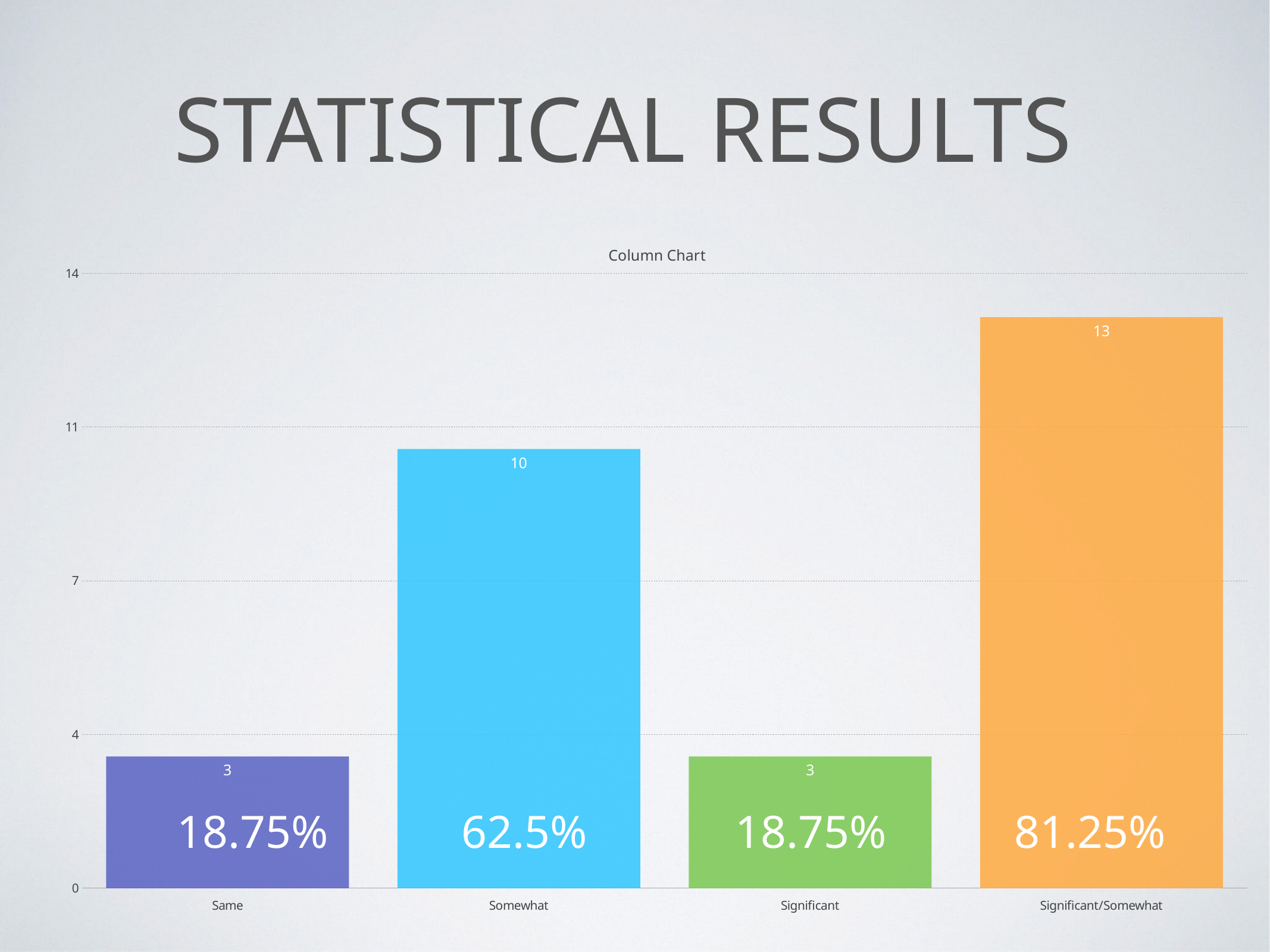
Which is larger, the value for Somewhat or the value for Same? Somewhat Is the value for Somewhat greater or less than 11? less What kind of chart is shown? bar chart What is the value for Same? 3 Which category has the highest value? Significant/Somewhat What is the title of the chart? Column Chart How many categories are shown on the x axis? 4 What percentage is printed on the Significant/Somewhat bar? 81.25% What is the difference between the values for Somewhat and Significant? 7 What is the value for Significant/Somewhat? 13 What is the difference between the values for Significant/Somewhat and Somewhat? 3 What is the value for Somewhat? 10